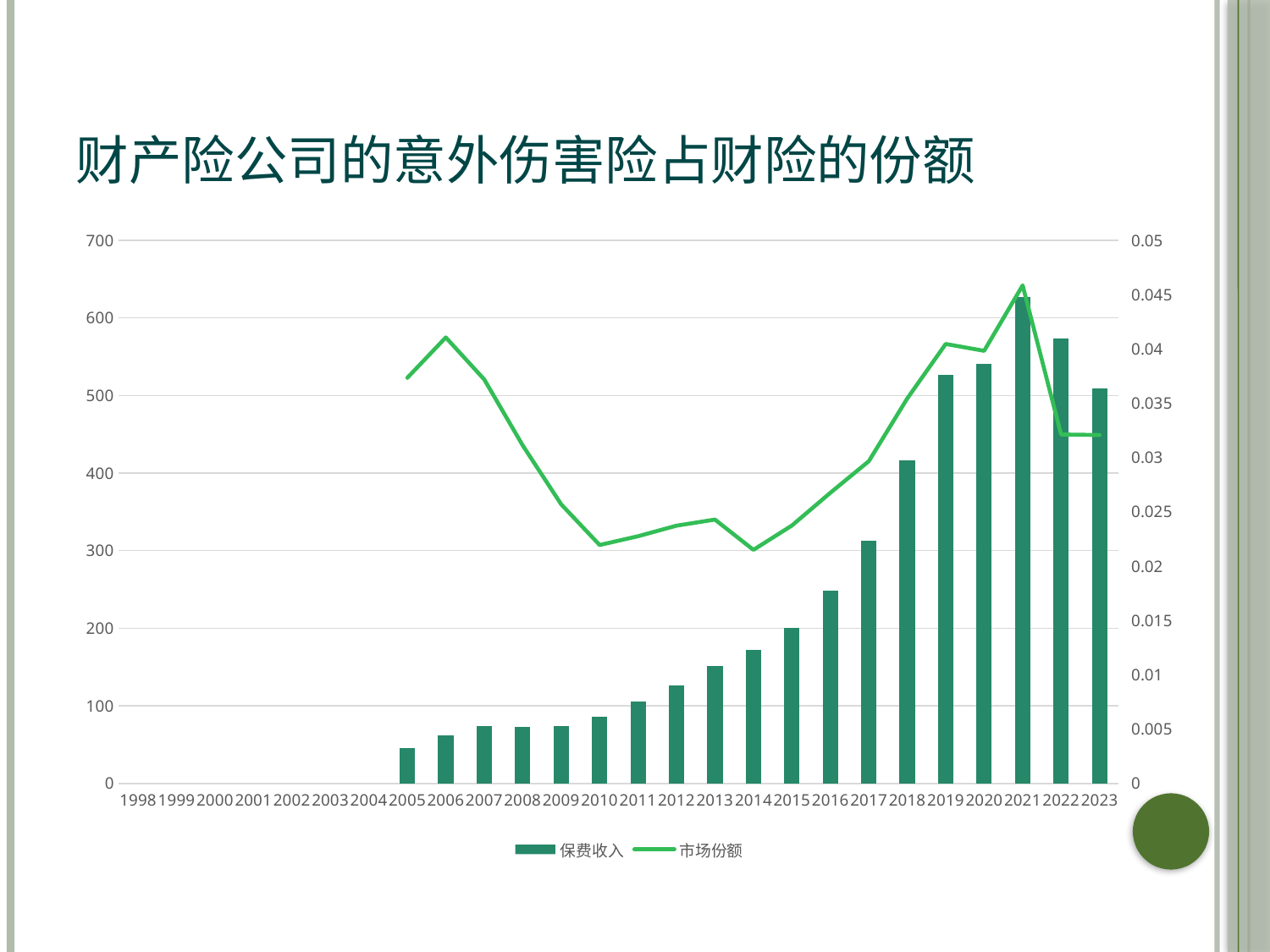
How many series does the legend list? 2 What kind of chart is shown on the slide? A combined bar and line chart Which year has the larger 保费收入 bar, 2022 or 2023? 2022 In which year is the 保费收入 bar the tallest? 2021 Is the 市场份额 value for 2010 greater or less than 0.025? less Does the 市场份额 line rise or fall from 2006 to 2010? Fall Is the 保费收入 value for 2021 greater or less than 600? greater In which year does the 市场份额 line reach its highest point? 2021 In which year is the 保费收入 bar the shortest? 2005 Which series is drawn as a line in the chart? 市场份额 Is the 保费收入 value for 2017 greater or less than 300? greater How many 保费收入 bars are plotted in the chart? 19